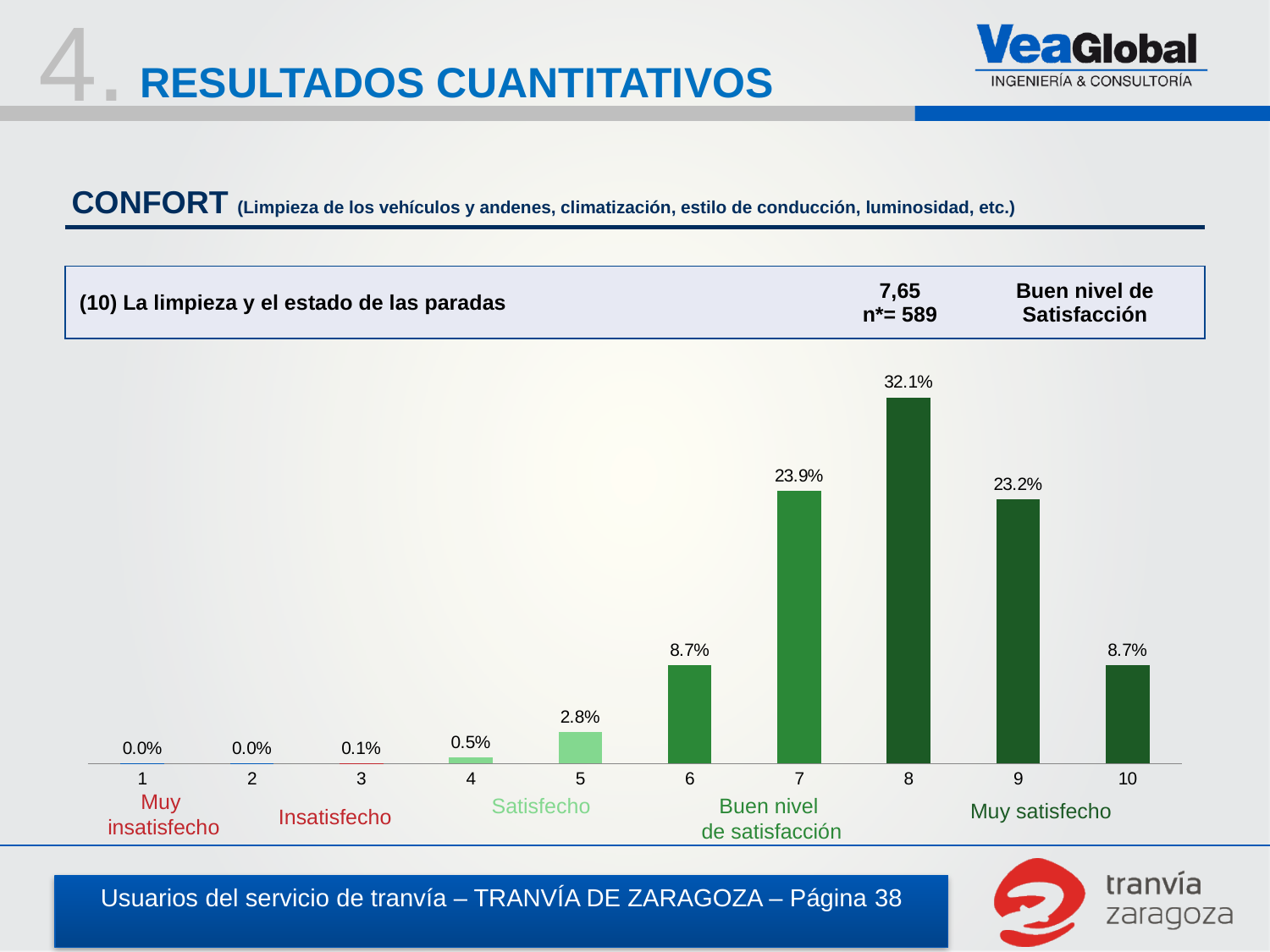
Which category has the highest value? 8 What is the value for category 9? 23.2% Do the values rise or fall from category 5 to category 8? Rise How many categories are shown on the x axis? 10 What is the value for category 4? 0.5% What is the difference between the values for categories 8 and 7? 8.2% What is the value for category 5? 2.8% What is the difference between the values for categories 6 and 10? 0.0% What kind of chart is shown? Bar chart Which is larger, the value for category 7 or the value for category 9? 7 What is the value for category 8? 32.1%